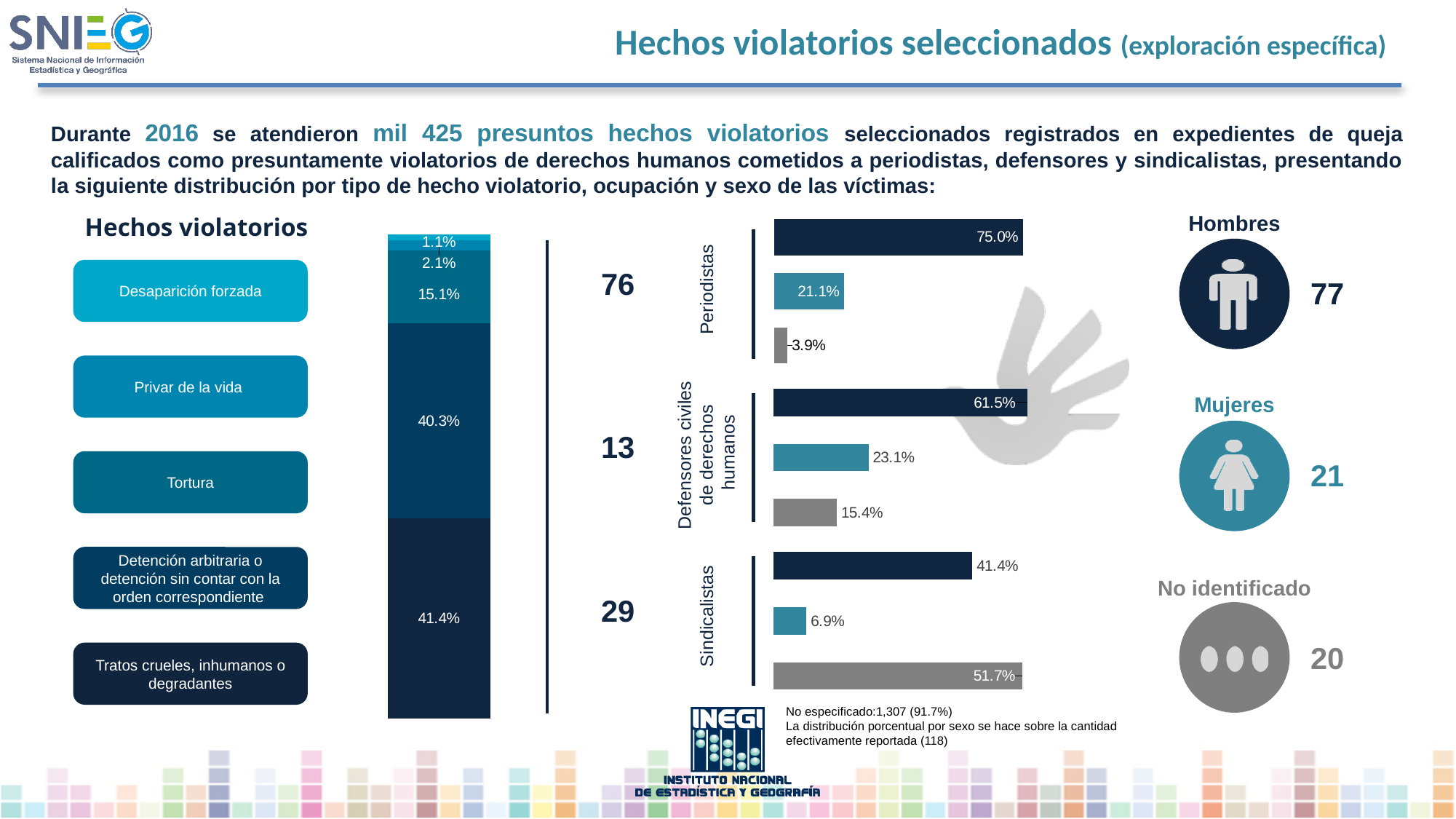
In the 'Hechos violatorios' stacked bar chart, what is the total of all the segments? 100% In the bar chart by occupation, what percentage is shown for the dark navy (Hombres) bar for Periodistas? 75.0% In the 'Hechos violatorios' stacked bar chart, how many segments make up the bar? 5 What type of chart is used to show the distribution by occupation and sex? Bar chart In the bar chart by occupation, what is the difference between the Hombres percentage for Periodistas and the Hombres percentage for Defensores civiles de derechos humanos? 13.5% In the 'Hechos violatorios' stacked bar chart, what percentage is shown for the smallest segment at the top of the bar? 1.1% In the 'Hechos violatorios' stacked bar chart, what is the difference between the 40.3% segment and the 15.1% segment? 25.2% In the bar chart by occupation, what percentage is shown for the teal (Mujeres) bar for Defensores civiles de derechos humanos? 23.1% In the 'Hechos violatorios' stacked bar chart, what percentage is shown for the largest segment at the bottom of the bar? 41.4% In the bar chart by occupation, which is larger for Sindicalistas: the dark navy (Hombres) bar or the gray (No identificado) bar? Gray (No identificado), 51.7% In the bar chart by occupation, which occupation has the lowest gray (No identificado) percentage? Periodistas In the bar chart by occupation, what percentage is shown for the gray (No identificado) bar for Sindicalistas? 51.7%